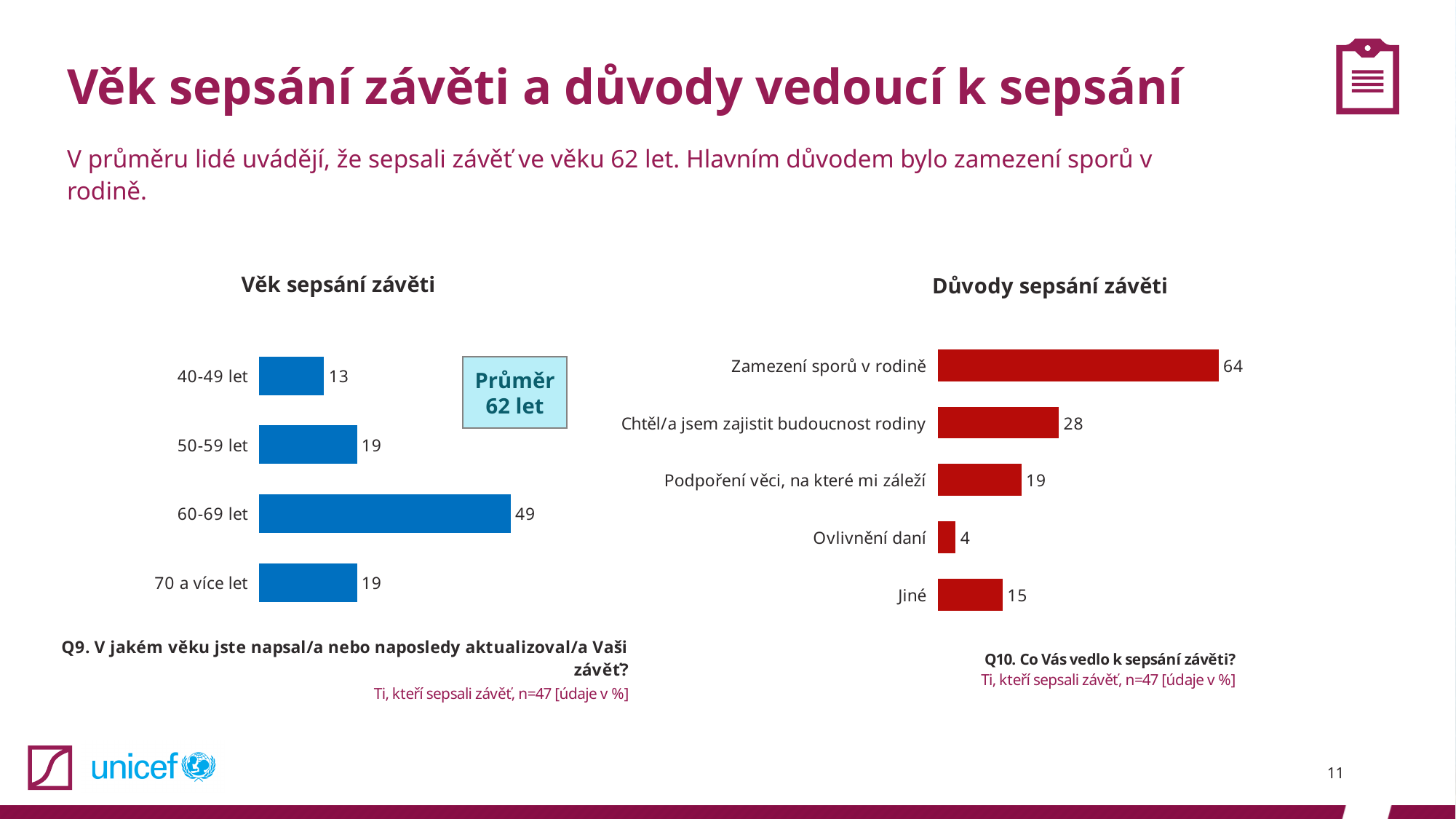
In the 'Věk sepsání závěti' chart, which age group has the lowest value? 40-49 let In the 'Věk sepsání závěti' chart, what average age is shown in the highlighted box? 62 let In the 'Důvody sepsání závěti' chart, which reason has the highest value? Zamezení sporů v rodině In the 'Důvody sepsání závěti' chart, which is larger: 'Jiné' or 'Ovlivnění daní'? Jiné In the 'Věk sepsání závěti' chart, how many age categories are shown? 4 In the 'Důvody sepsání závěti' chart, which reason has the lowest value? Ovlivnění daní In the 'Důvody sepsání závěti' chart, what is the value for 'Chtěl/a jsem zajistit budoucnost rodiny'? 28 In the 'Věk sepsání závěti' chart, what is the difference between the values for 60-69 let and 40-49 let? 36 In the 'Důvody sepsání závěti' chart, how many reasons are listed? 5 In the 'Důvody sepsání závěti' chart, what is the difference between 'Zamezení sporů v rodině' and 'Podpoření věci, na které mi záleží'? 45 What type of chart is the 'Důvody sepsání závěti' chart? Bar chart In the 'Věk sepsání závěti' chart, what is the value for 60-69 let? 49